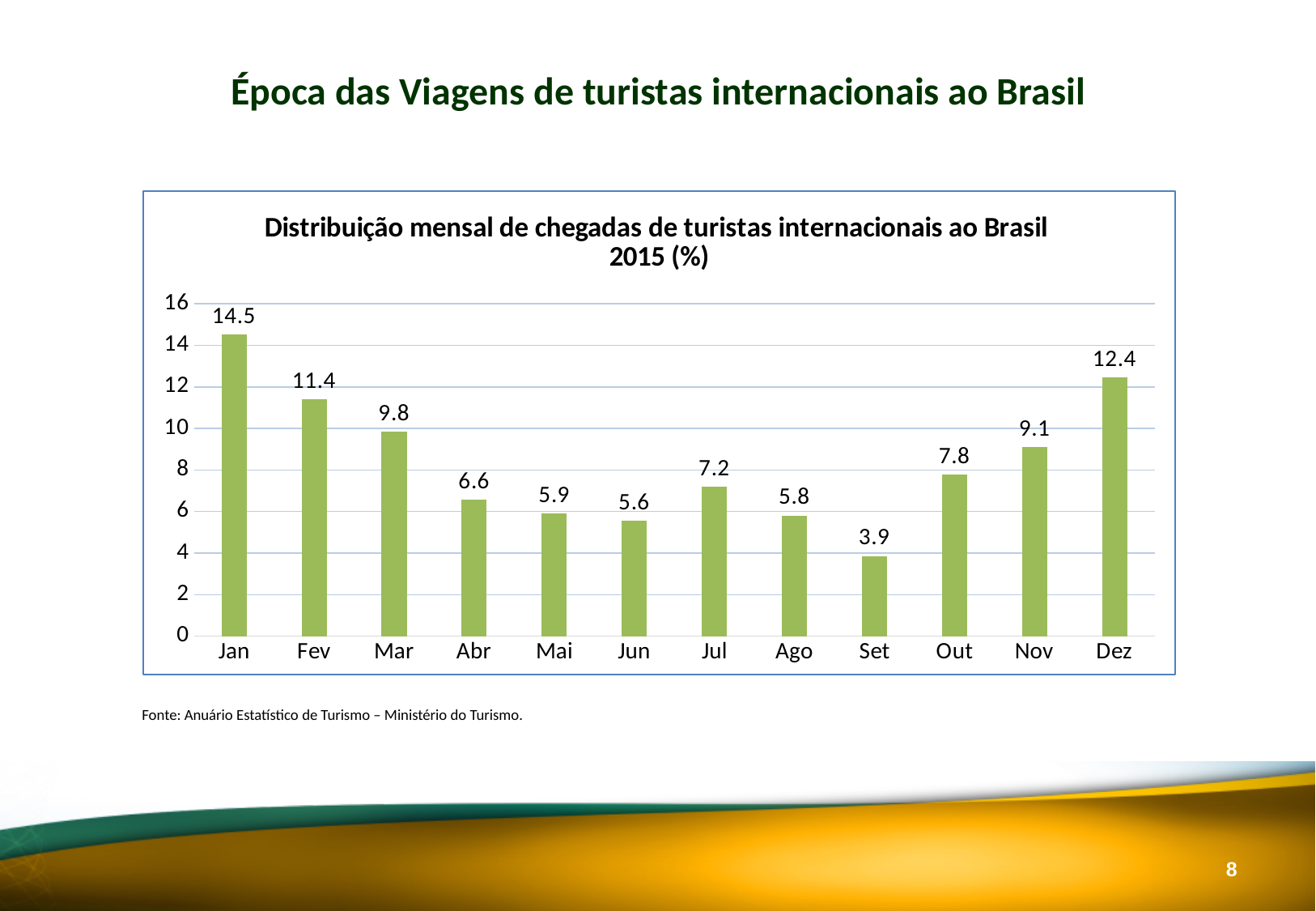
How many months are shown on the x axis? 12 Which is larger, the value for Jul or the value for Ago? Jul Is the value for Mar greater or less than 8? greater What is the title of the chart? Distribuição mensal de chegadas de turistas internacionais ao Brasil 2015 (%) What kind of chart is this? bar chart What is the value for Set? 3.9 What is the difference between the values for Jan and Fev? 3.1 What is the value for Jan? 14.5 Which month has the highest value? Jan What is the difference between the values for Dez and Nov? 3.3 What is the value for Dez? 12.4 Which month has the lowest value? Set